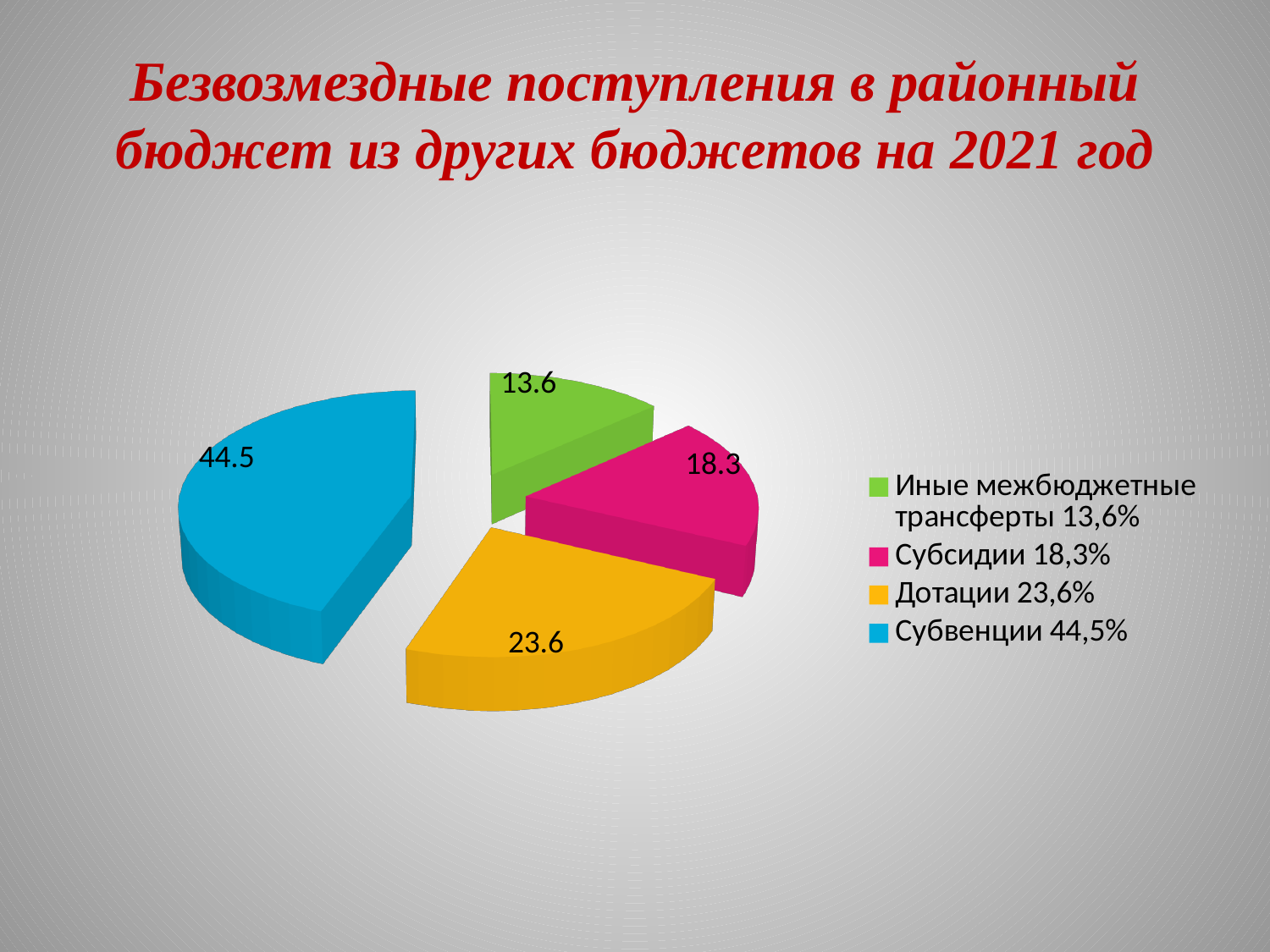
Which category has the smallest slice of the pie? Иные межбюджетные трансферты What is the difference between the values for Субвенции and Дотации? 20.9 What colour is the slice for Субвенции? blue Which is larger, the value for Субсидии or the value for Дотации? Дотации What type of chart is shown on the slide? pie chart What is the value shown for Субсидии? 18.3 What is the title of the chart on the slide? Безвозмездные поступления в районный бюджет из других бюджетов на 2021 год What is the value shown for Субвенции? 44.5 How many slices does the pie chart have? 4 What is the value shown for Дотации? 23.6 What is the value shown for Иные межбюджетные трансферты? 13.6 Which category has the largest slice of the pie? Субвенции